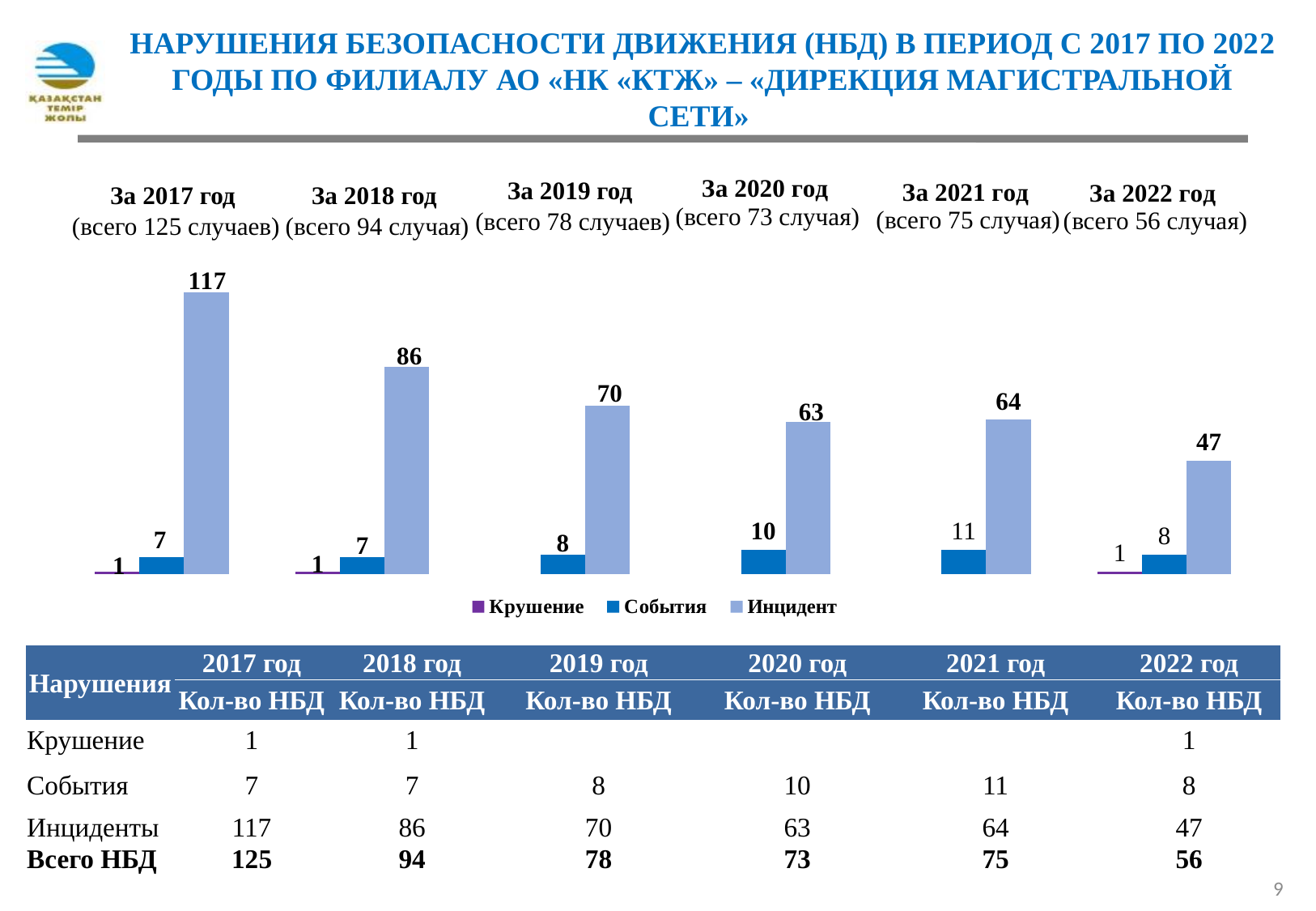
What kind of chart is shown on the slide? bar chart What is the value of Инцидент for 2022 (За 2022 год)? 47 Which is larger, the События value for 2020 or for 2022? 2020 In which year is the Инцидент value highest? 2017 Which series is shown in light blue in the chart legend? Инцидент How many series does the chart legend list? 3 What is the difference between the Инцидент values for 2017 and 2018? 31 Does the Инцидент value generally rise or fall from 2017 to 2022? fall What is the value of Инцидент for 2017 (За 2017 год)? 117 In which year is the Инцидент value lowest? 2022 What is the value of События for 2021 (За 2021 год)? 11 How many year groups are shown on the x axis of the chart? 6